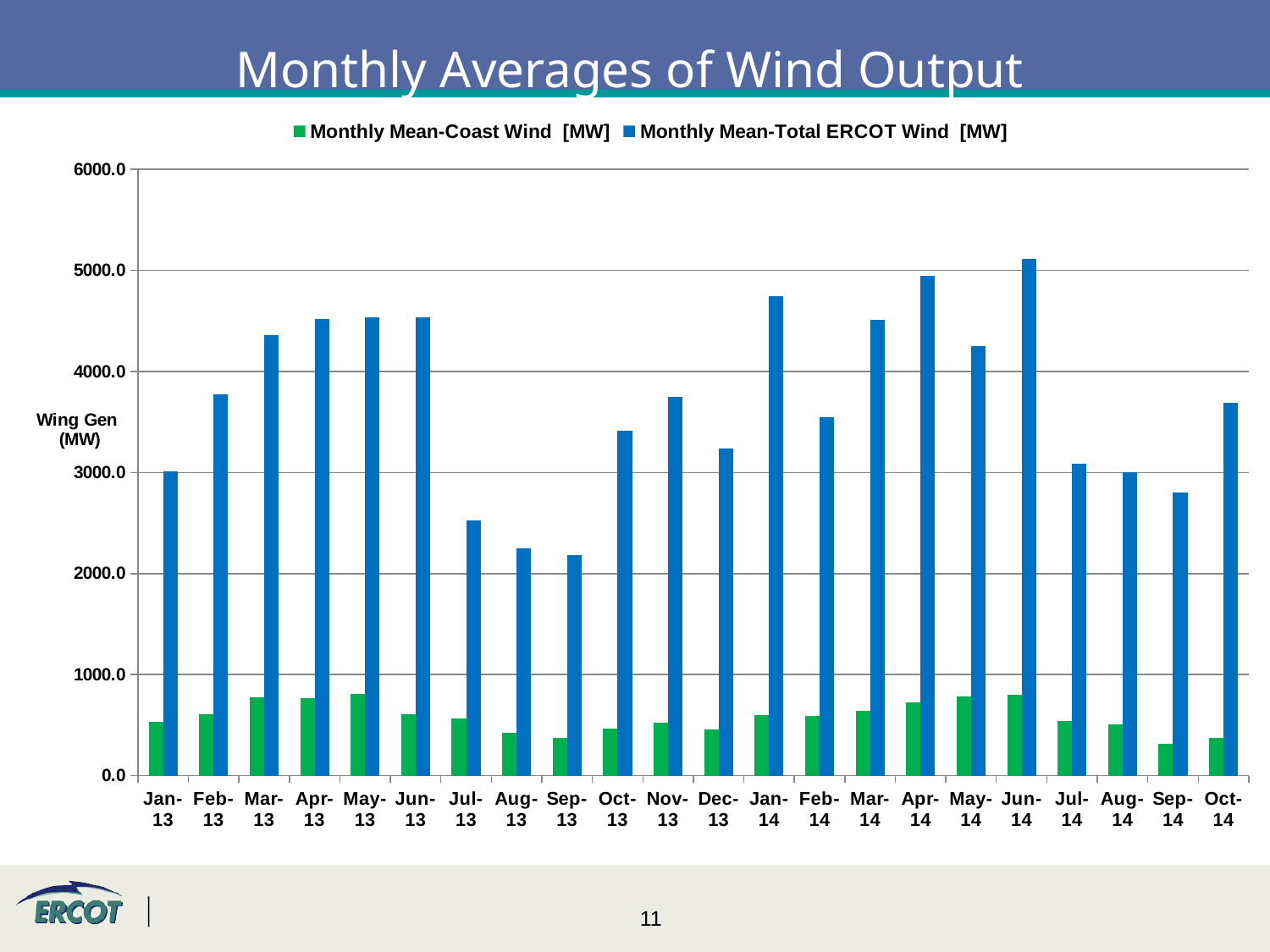
What kind of chart is shown on the slide? bar chart How many series does the legend list? 2 Which month has the highest Monthly Mean-Total ERCOT Wind value? Jun-14 Is the Monthly Mean-Coast Wind value for Jan-13 greater or less than 1000.0? less Do the Monthly Mean-Total ERCOT Wind values rise or fall from Jun-13 to Sep-13? fall What is the label on the y axis? Wing Gen (MW) Is the Monthly Mean-Total ERCOT Wind value for Jun-14 greater or less than 5000.0? greater Which month has the larger Monthly Mean-Total ERCOT Wind value, Jan-14 or Feb-14? Jan-14 Is the Monthly Mean-Total ERCOT Wind value for Jan-14 greater or less than 4000.0? greater How many months are shown along the x axis? 22 Which month has the lowest Monthly Mean-Coast Wind value? Sep-14